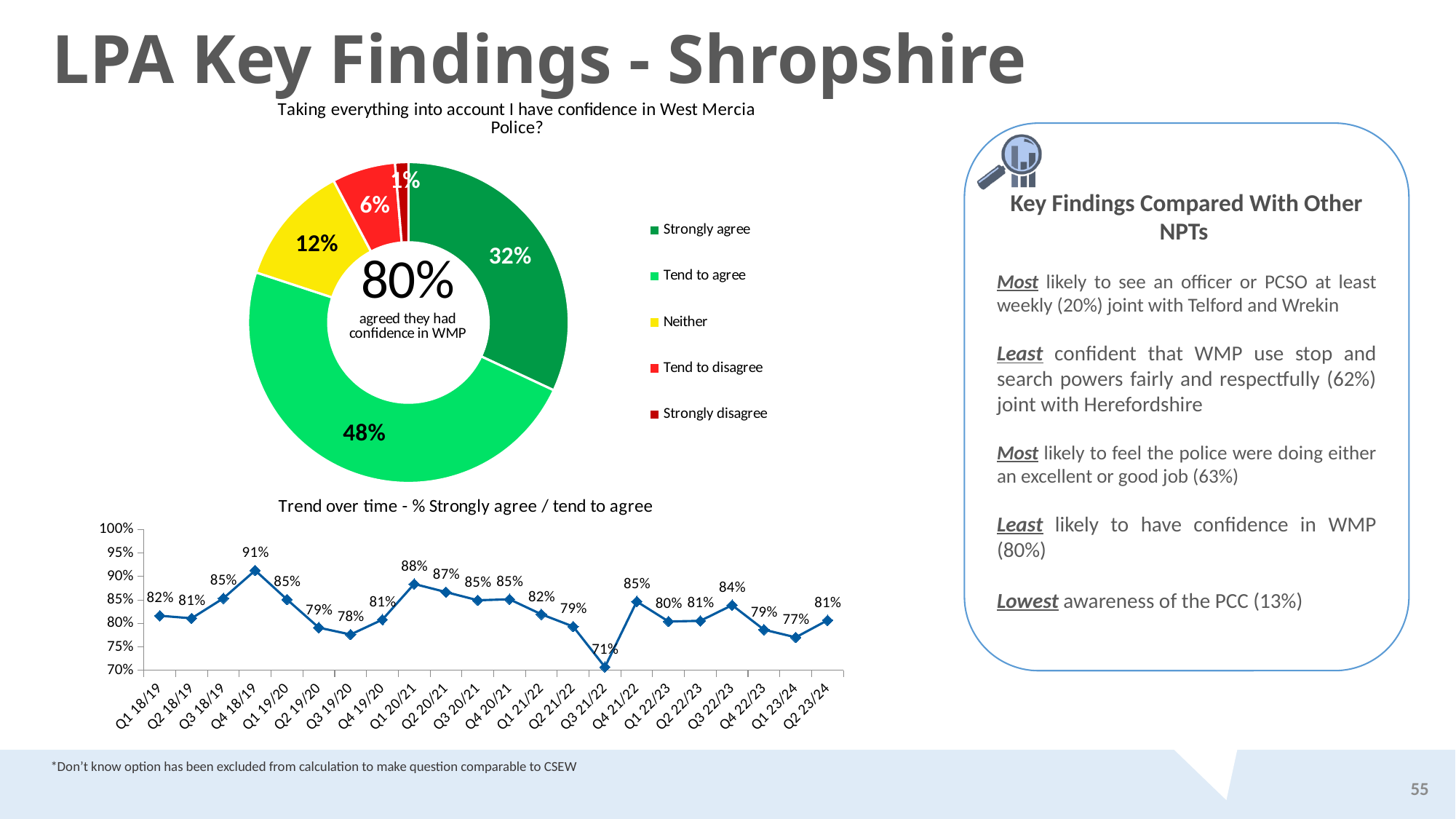
In the doughnut chart 'Taking everything into account I have confidence in West Mercia Police?', what percentage is shown for 'Strongly disagree'? 1% In the doughnut chart 'Taking everything into account I have confidence in West Mercia Police?', which category has the largest share? Tend to agree How many data points are plotted in the chart 'Trend over time - % Strongly agree / tend to agree'? 22 In the chart 'Trend over time - % Strongly agree / tend to agree', which is larger: the value for Q1 20/21 or the value for Q1 23/24? Q1 20/21 How many categories does the legend of the doughnut chart 'Taking everything into account I have confidence in West Mercia Police?' list? 5 In the chart 'Trend over time - % Strongly agree / tend to agree', what is the value for Q4 18/19? 91% In the chart 'Trend over time - % Strongly agree / tend to agree', what is the value for Q2 23/24? 81% In the chart 'Trend over time - % Strongly agree / tend to agree', which quarter has the lowest value? Q3 21/22 In the doughnut chart 'Taking everything into account I have confidence in West Mercia Police?', what percentage is shown for 'Tend to agree'? 48% In the doughnut chart 'Taking everything into account I have confidence in West Mercia Police?', what colour represents 'Neither'? Yellow What type of chart is 'Trend over time - % Strongly agree / tend to agree'? Line chart In the doughnut chart 'Taking everything into account I have confidence in West Mercia Police?', what is the difference between the 'Strongly agree' and 'Neither' percentages? 20%